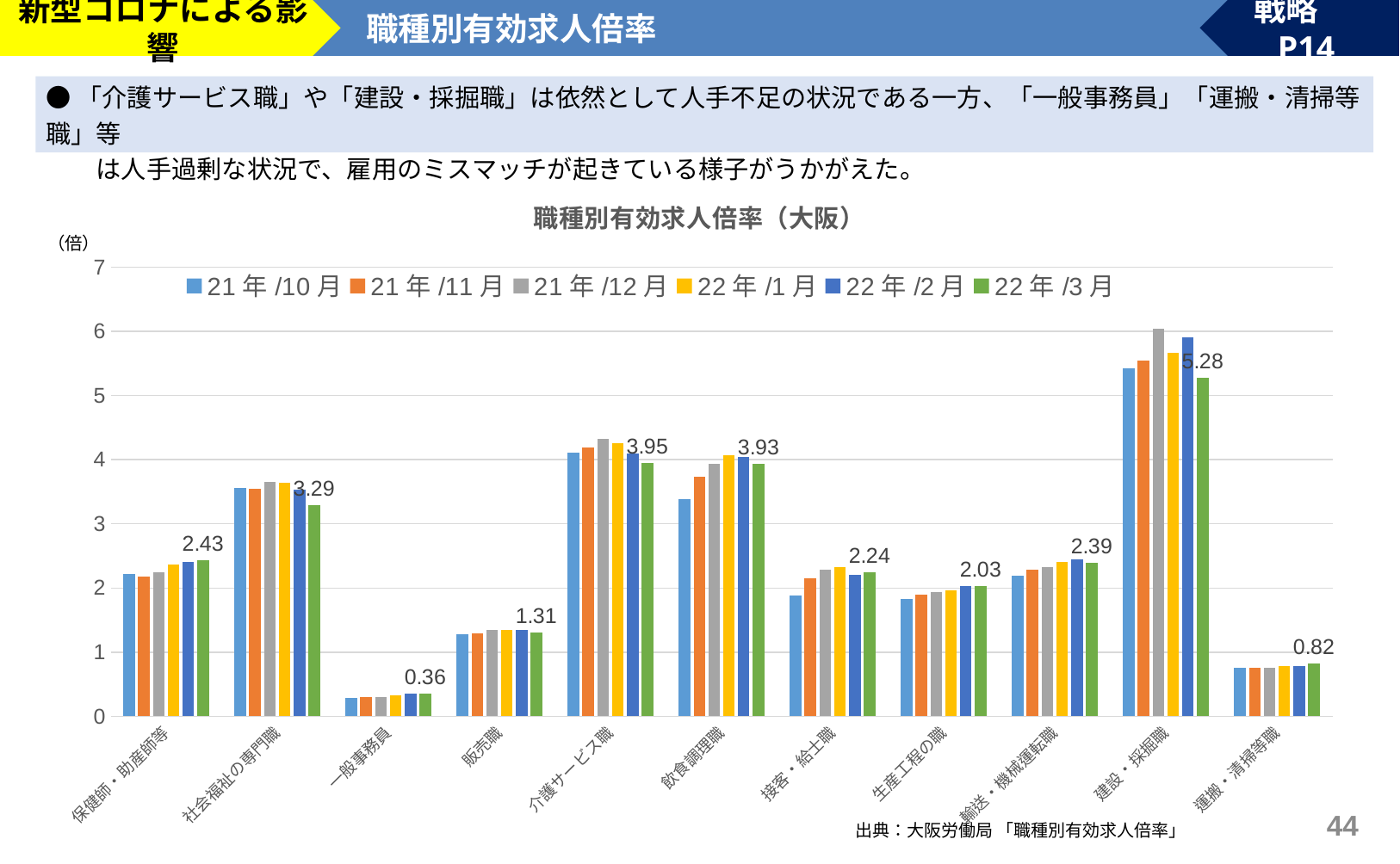
What is the difference between the 22年/3月 values for 建設・採掘職 and 介護サービス職? 1.33 Which occupation has the highest value in 22年/3月? 建設・採掘職 What type of chart is shown on the slide? bar chart Which occupation has the lowest value in 22年/3月? 一般事務員 What is the value for 運搬・清掃等職 in 22年/3月? 0.82 What is the value for 建設・採掘職 in 22年/3月? 5.28 What is the value for 一般事務員 in 22年/3月? 0.36 Which is larger in 22年/3月: 接客・給仕職 or 生産工程の職? 接客・給士職 How many series does the legend list in the chart 職種別有効求人倍率（大阪）? 6 What is the value for 介護サービス職 in 22年/3月? 3.95 How many occupation categories are shown on the x axis of the chart? 11